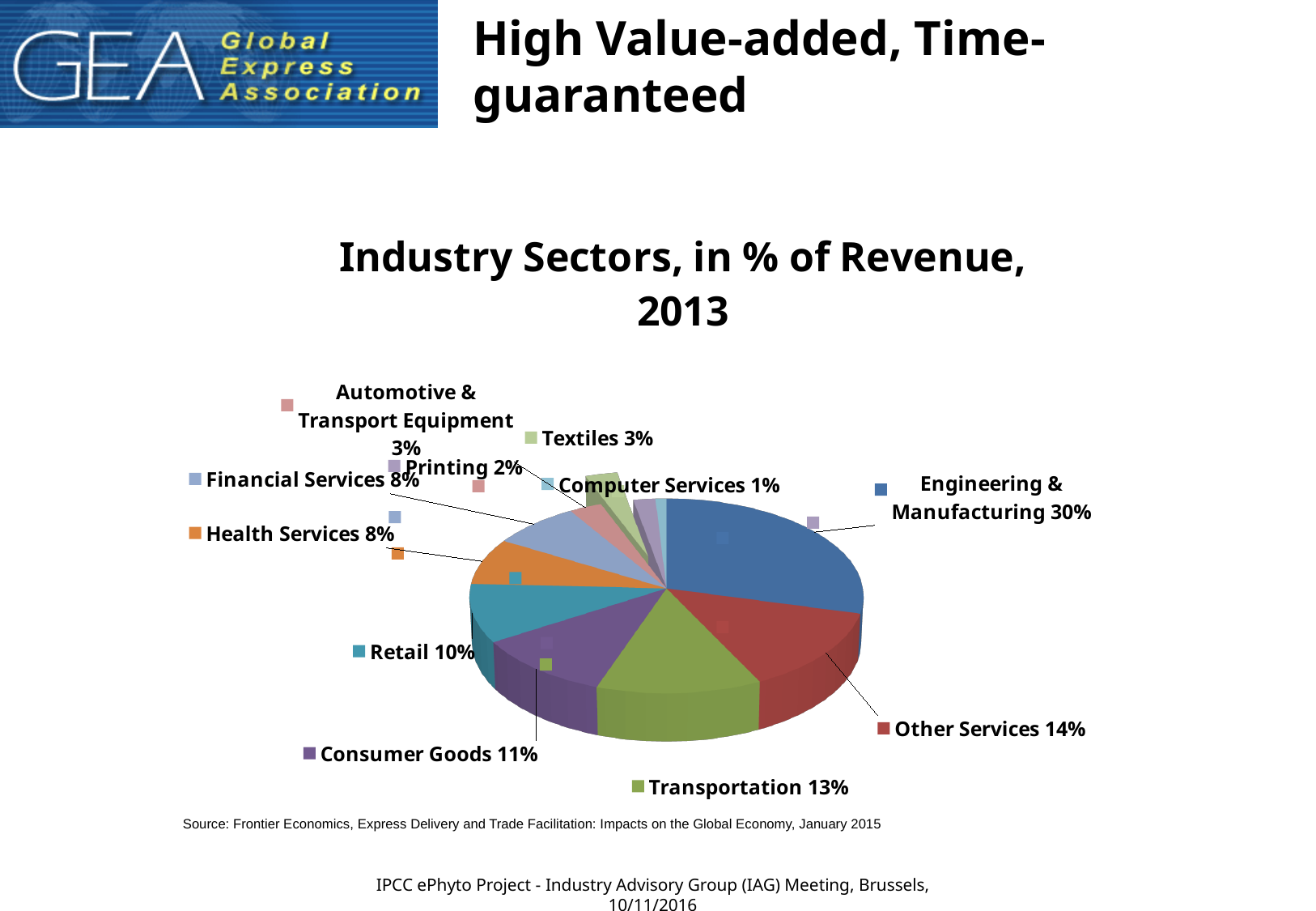
What percentage of revenue is attributed to Transportation? 13% Which industry sector has the smallest share of revenue? Computer Services How many industry sectors are shown in the pie chart? 11 What percentage is shown for Computer Services? 1% What is the combined share of Financial Services and Health Services? 16% Which has a larger share of revenue, Retail or Health Services? Retail Which industry sector has the largest share of revenue? Engineering & Manufacturing What is the title of the chart? Industry Sectors, in % of Revenue, 2013 What is the value shown for Retail? 10% What is the difference in percentage points between Other Services and Consumer Goods? 3 What kind of chart is shown on the slide? Pie chart What share of revenue does Engineering & Manufacturing account for? 30%